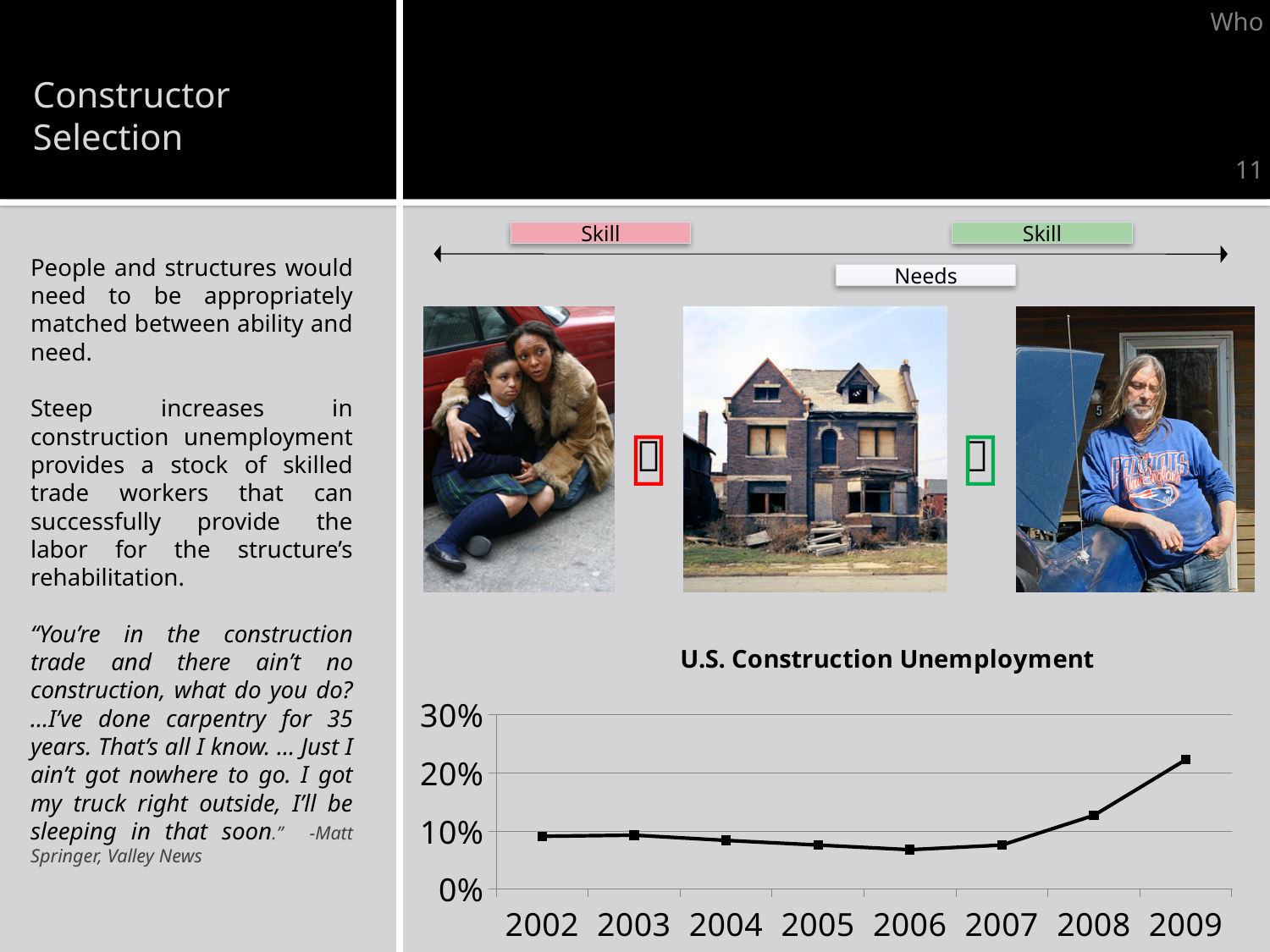
In the U.S. Construction Unemployment chart, which year has the larger value, 2002 or 2009? 2009 How many years are plotted on the x axis of the U.S. Construction Unemployment chart? 8 In the U.S. Construction Unemployment chart, do the values rise or fall from 2007 to 2009? rise What is the title of the chart on the slide? U.S. Construction Unemployment Is the value for 2005 in the U.S. Construction Unemployment chart greater or less than 10%? less Is the value for 2008 in the U.S. Construction Unemployment chart greater or less than 10%? greater What kind of chart is the U.S. Construction Unemployment chart? line chart Is the value for 2009 in the U.S. Construction Unemployment chart greater or less than 20%? greater In the U.S. Construction Unemployment chart, which year has the larger value, 2006 or 2008? 2008 What is the highest tick label shown on the y axis of the U.S. Construction Unemployment chart? 30% Which year has the highest value in the U.S. Construction Unemployment chart? 2009